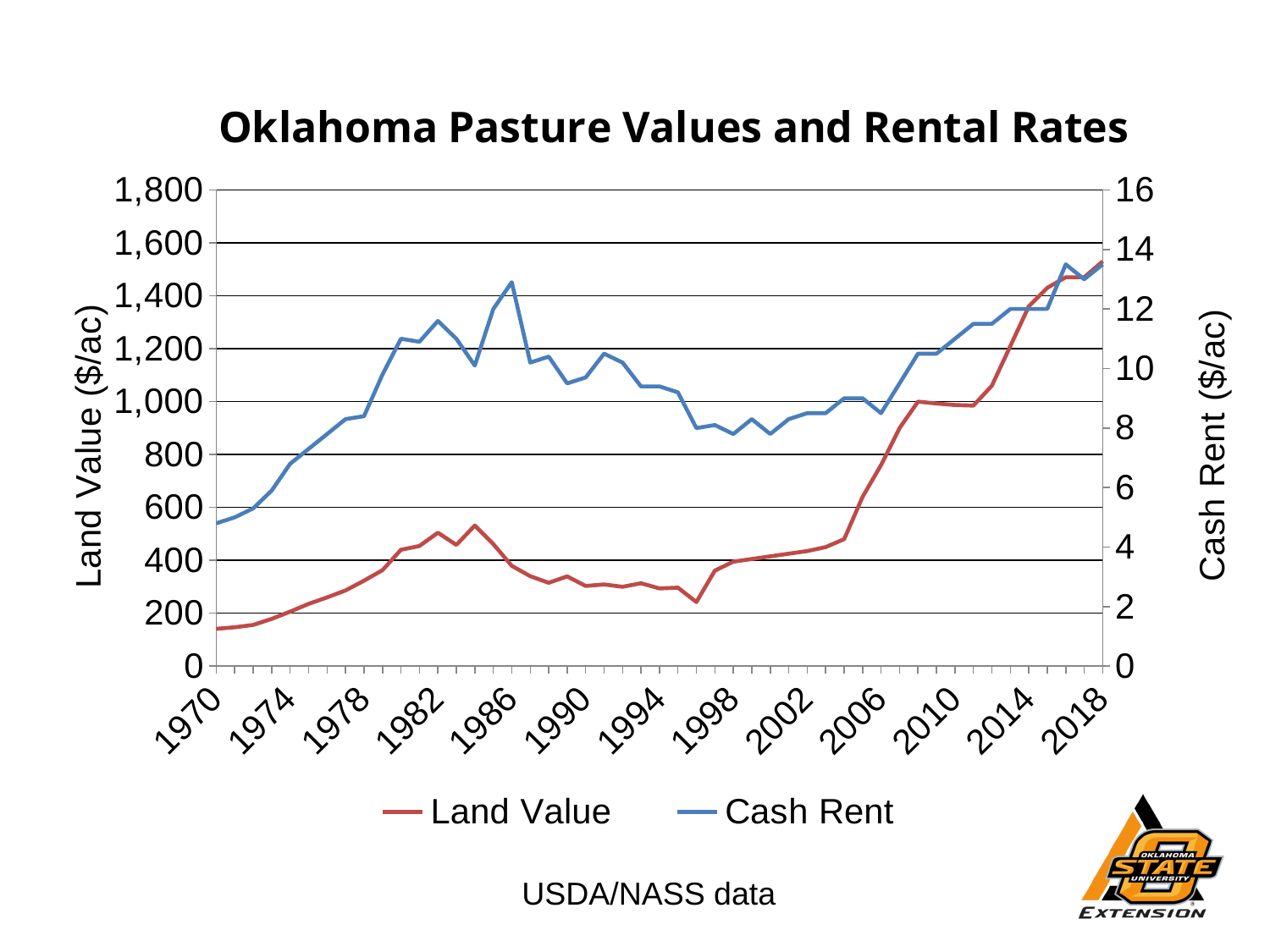
Is the Land Value in 1970 greater or less than 200? less What kind of chart is shown on the slide? Line chart Does the Land Value series rise or fall between 2006 and 2018? rise Is the Land Value in 1994 greater or less than 400? less How many series does the legend list? 2 Does the Cash Rent series rise or fall between 1986 and 1998? fall What is the title of the chart? Oklahoma Pasture Values and Rental Rates Is the Cash Rent in 1986 greater or less than 12? greater What is the label on the right-hand vertical axis? Cash Rent ($/ac)